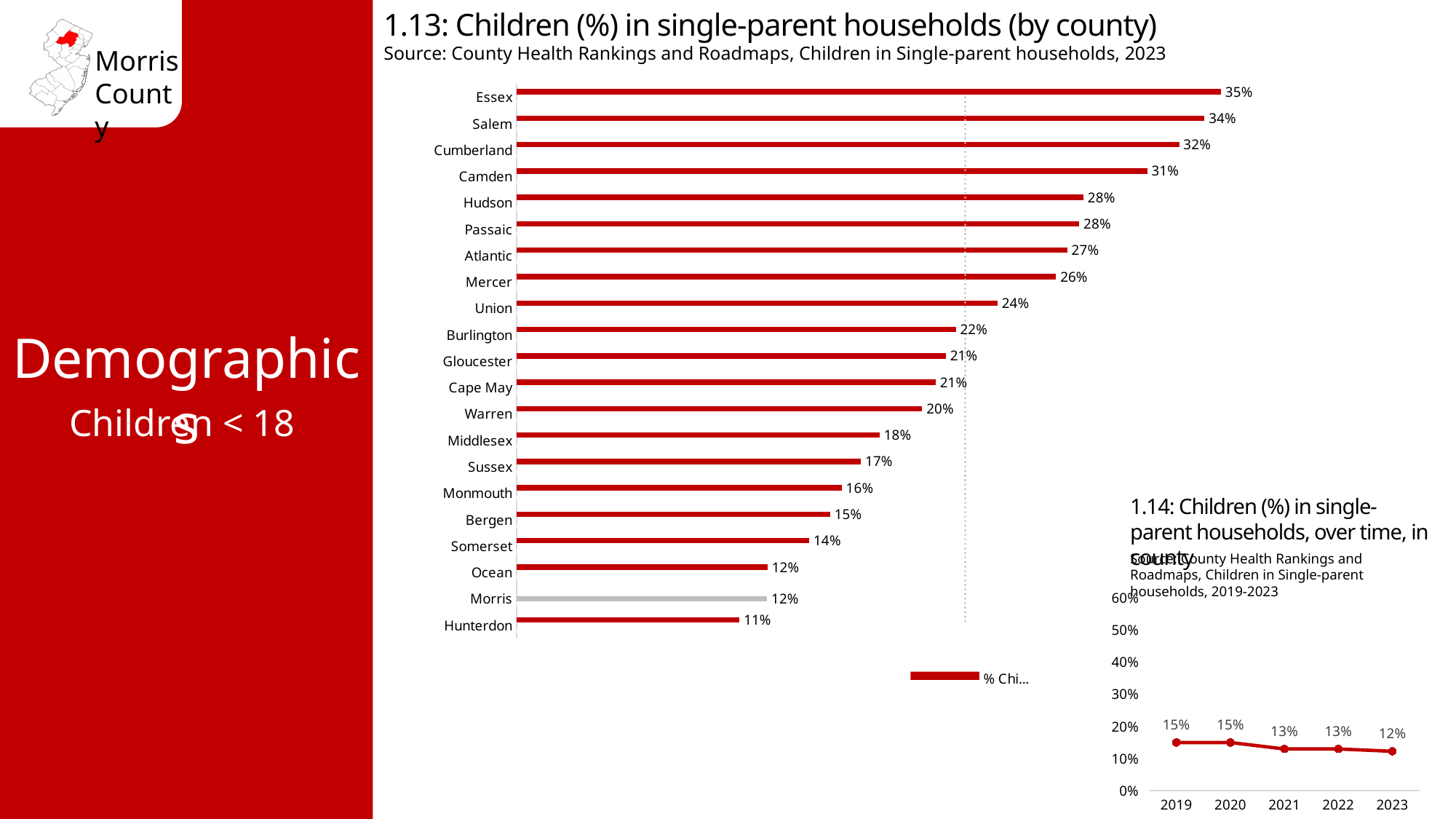
In chart 1.13 (by county), which has a higher value, Union or Middlesex? Union In chart 1.13 (by county), which county has the lowest percentage of children in single-parent households? Hunterdon What kind of chart is chart 1.13 (Children (%) in single-parent households by county)? Bar chart In chart 1.13 (by county), what is the difference between the values for Camden and Bergen? 16% In chart 1.14 (Children (%) in single-parent households over time), what is the value for 2021? 13% In chart 1.14 (over time), how many years are plotted? 5 In chart 1.14 (over time), what is the difference between the 2019 value and the 2023 value? 3% In chart 1.13 (Children (%) in single-parent households by county), what is the value for Essex? 35% In chart 1.13 (by county), which county has the highest percentage of children in single-parent households? Essex In chart 1.13 (by county), how many counties are shown? 21 In chart 1.14 (over time), do the values rise or fall from 2019 to 2023? Fall In chart 1.13 (by county), what is the value for Morris? 12%